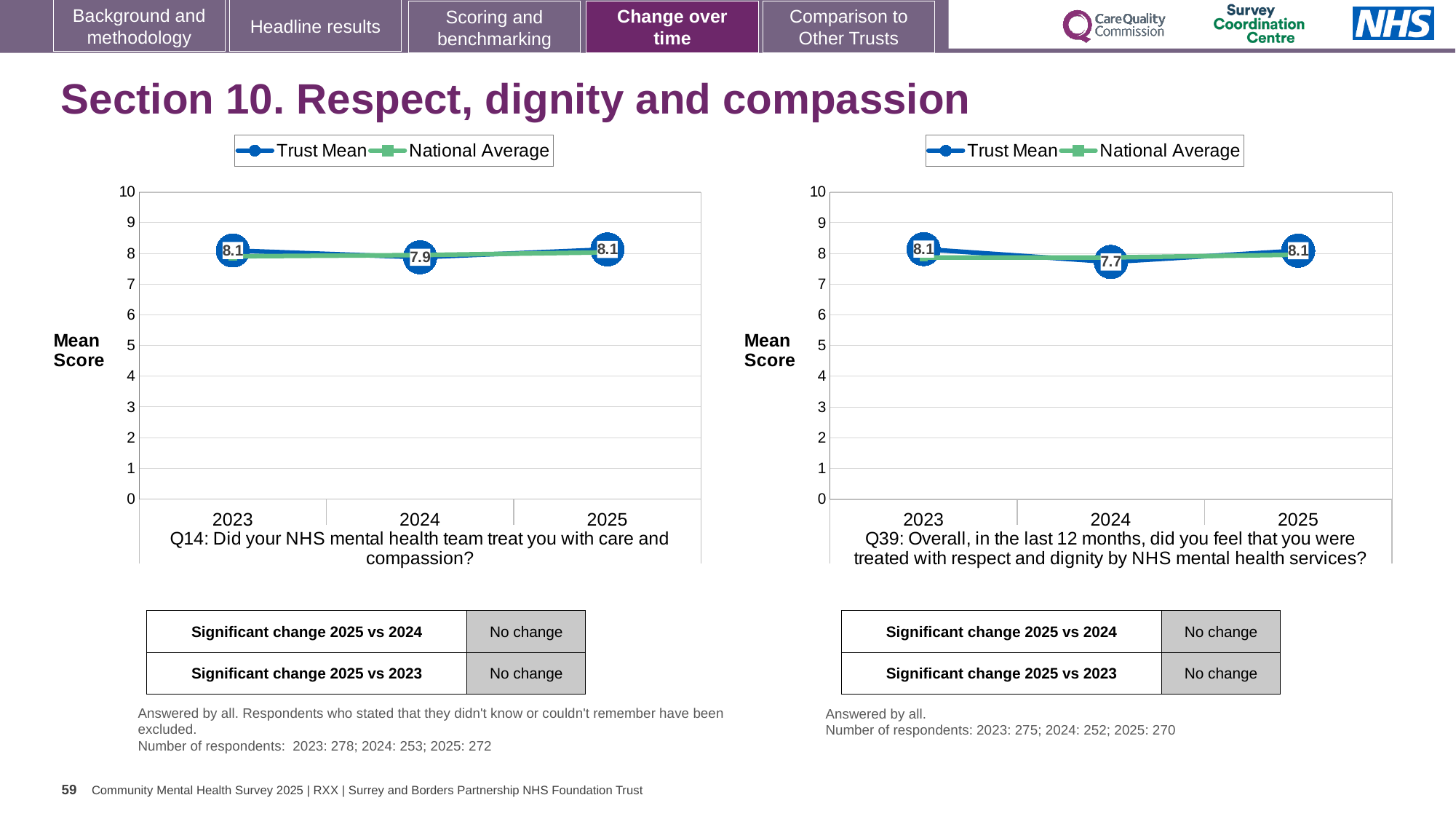
In the Q14 chart (left), what is the Trust Mean for 2024? 7.9 Which is larger: the Trust Mean for 2024 in the Q14 chart (left) or the Trust Mean for 2024 in the Q39 chart (right)? Q14 chart (left) How many years are plotted on the x axis of the Q39 chart (right)? 3 In the Q14 chart (left), is the Trust Mean for 2023 greater or less than 7? greater In the Q39 chart (right), what is the Trust Mean for 2023? 8.1 What kind of chart is the Q39 chart (right)? Line chart In the Q14 chart (left), what is the Trust Mean for 2025? 8.1 How many series does the legend of the Q14 chart (left) list? 2 In the Q39 chart (right), which year has the lowest Trust Mean? 2024 In the Q14 chart (left), what is the difference between the Trust Mean in 2025 and in 2024? 0.2 In the Q39 chart (right), what is the difference between the Trust Mean in 2023 and in 2024? 0.4 In the Q39 chart (right), what is the Trust Mean for 2024? 7.7